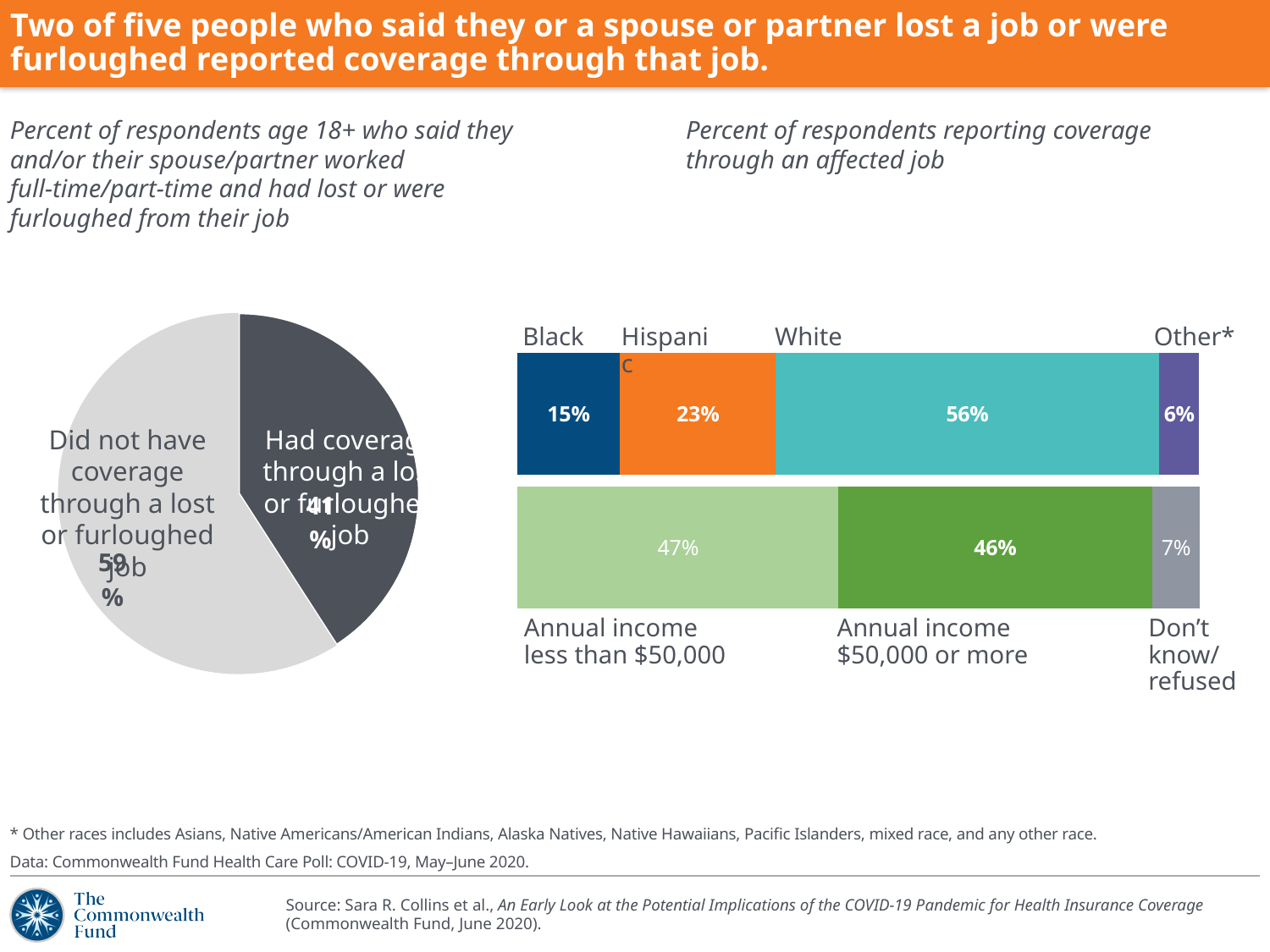
What kind of chart is shown on the left side of the slide? Pie chart In the race bar on the right, what percent of respondents are Hispanic? 23% In the pie chart on the left, what percent of respondents did not have coverage through a lost or furloughed job? 59% In the income bar on the right, what is the total of the three segments? 100% In the pie chart on the left, what percent of respondents had coverage through a lost or furloughed job? 41% In the race bar on the right, what is the difference between the White share and the Black share? 41 percentage points In the pie chart on the left, how many slices are there? 2 In the income bar on the right, what percent of respondents have annual income of $50,000 or more? 46% In the race bar on the right, what percent of respondents reporting coverage through an affected job are White? 56% In the race bar on the right, which group has the smallest share? Other* In the income bar on the right, what percent of respondents answered 'Don't know/refused'? 7% In the pie chart on the left, which slice is larger: 'Had coverage through a lost or furloughed job' or 'Did not have coverage through a lost or furloughed job'? Did not have coverage through a lost or furloughed job